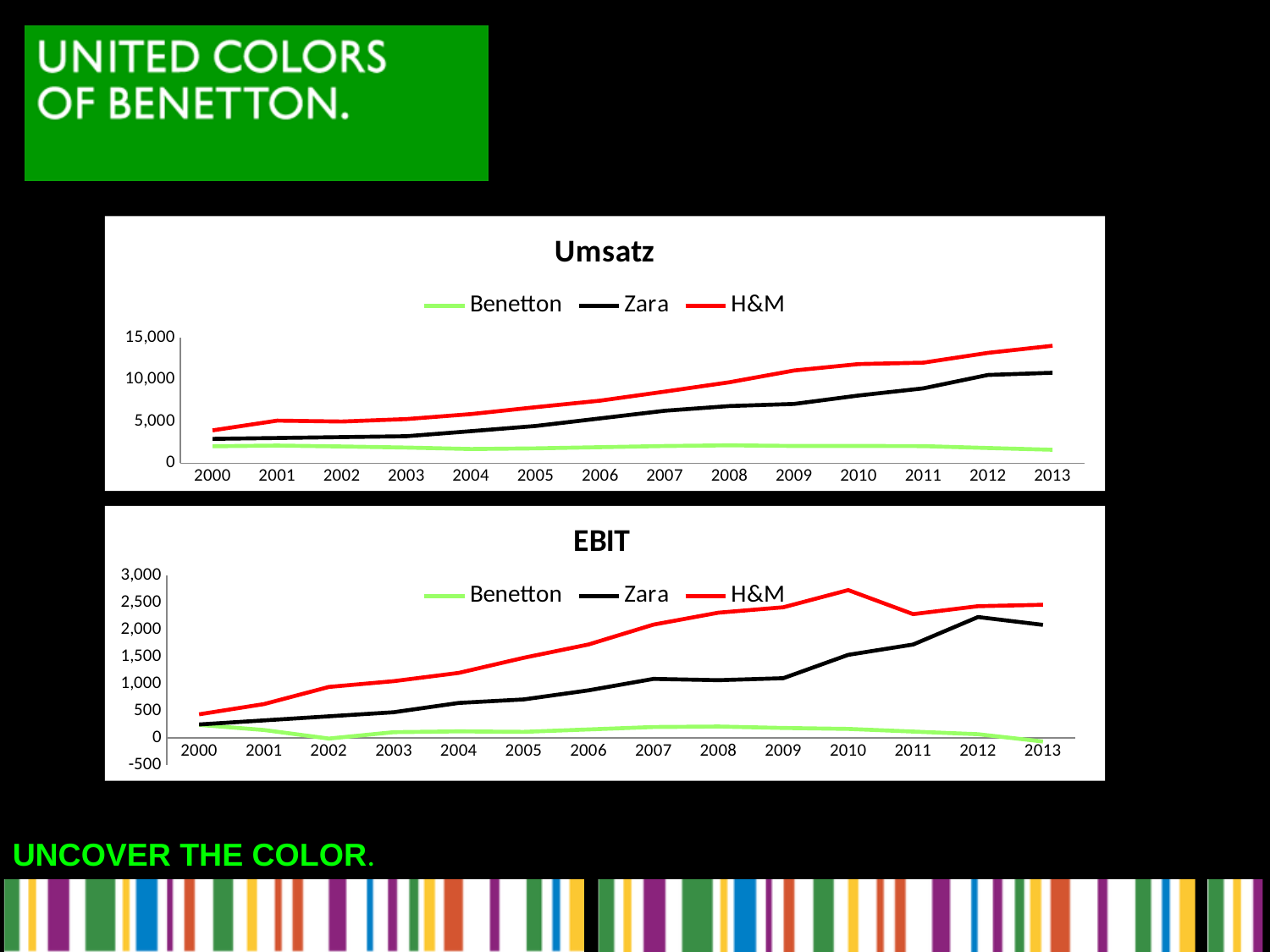
In the EBIT chart, is the value for H&M in 2010 greater or less than 2,500? greater What colour is the Zara line in the Umsatz chart? black What type of chart is the Umsatz chart? line chart How many series does the legend of the EBIT chart list? 3 In the Umsatz chart, is the value for H&M in 2013 greater or less than 10,000? greater In the Umsatz chart, is the value for Benetton in 2013 greater or less than 5,000? less In the Umsatz chart, which series has the highest value in 2013? H&M How many years are shown on the x axis of the Umsatz chart? 14 In the EBIT chart, which series has the lowest value in 2013? Benetton In the Umsatz chart, does the H&M series generally rise or fall from 2000 to 2013? rise In the EBIT chart, which is larger in 2013, the value for H&M or the value for Zara? H&M